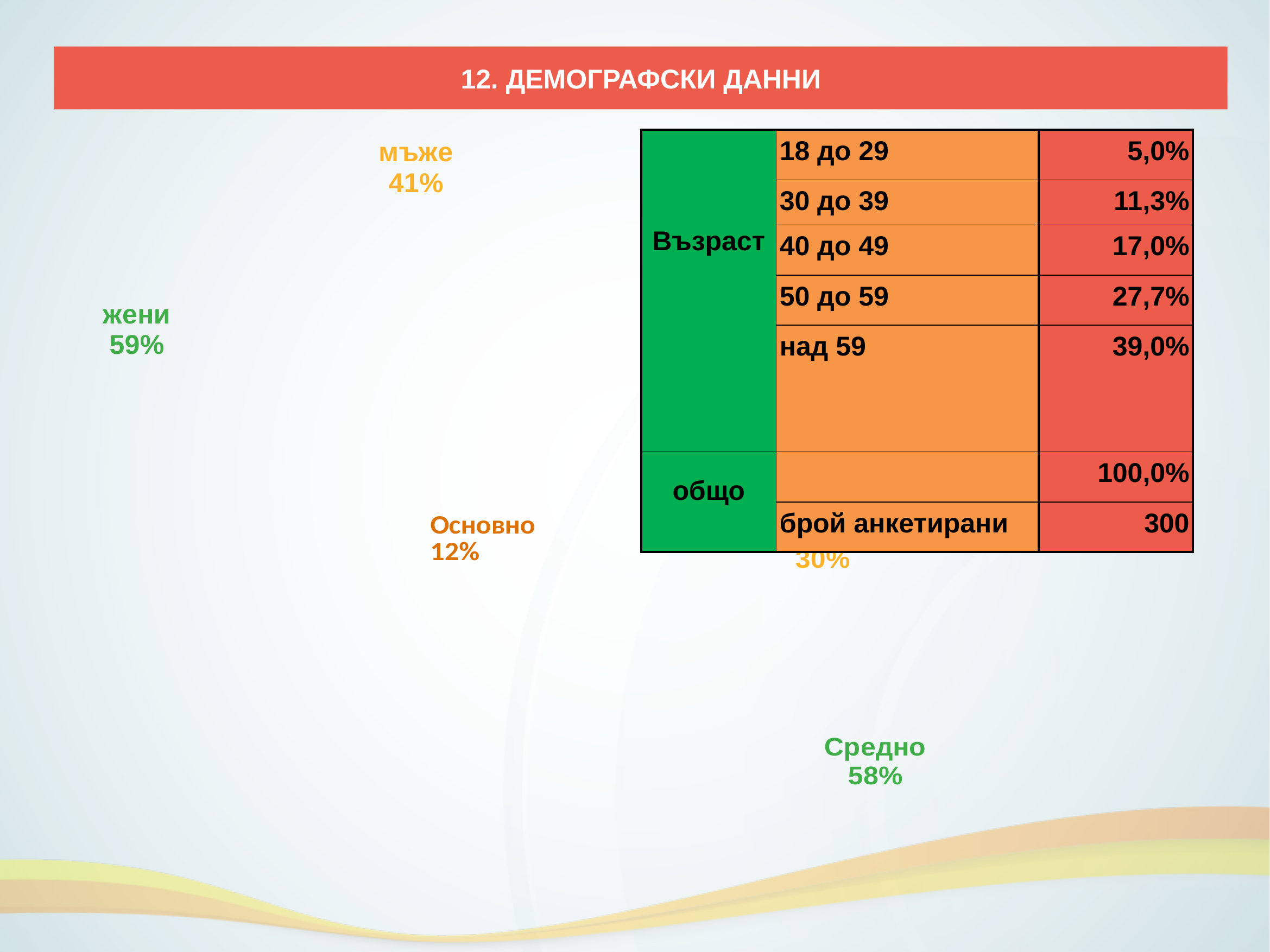
In the upper-left chart with the labels мъже and жени, what is the value for мъже? 41% In the lower chart with the labels Основно and Средно, what is the value for Основно? 12% In the upper-left chart with the labels мъже and жени, what is the value for жени? 59% In the lower chart with the labels Основно and Средно, which is larger, Основно or Средно? Средно In the upper-left chart with the labels мъже and жени, what is the difference between the жени and мъже values? 18% In the upper-left chart with the labels мъже and жени, which category has the smaller share? мъже In the lower chart with the labels Основно and Средно, what is the difference between the Средно and Основно values? 46% In the upper-left chart with the labels мъже and жени, is the value for жени greater or less than 50%? greater What colour is the label text for жени in the upper-left chart? green In the lower chart with the labels Основно and Средно, what is the value for Средно? 58% In the upper-left chart with the labels мъже and жени, how many categories are labelled? 2 In the upper-left chart with the labels мъже and жени, which category has the larger share? жени